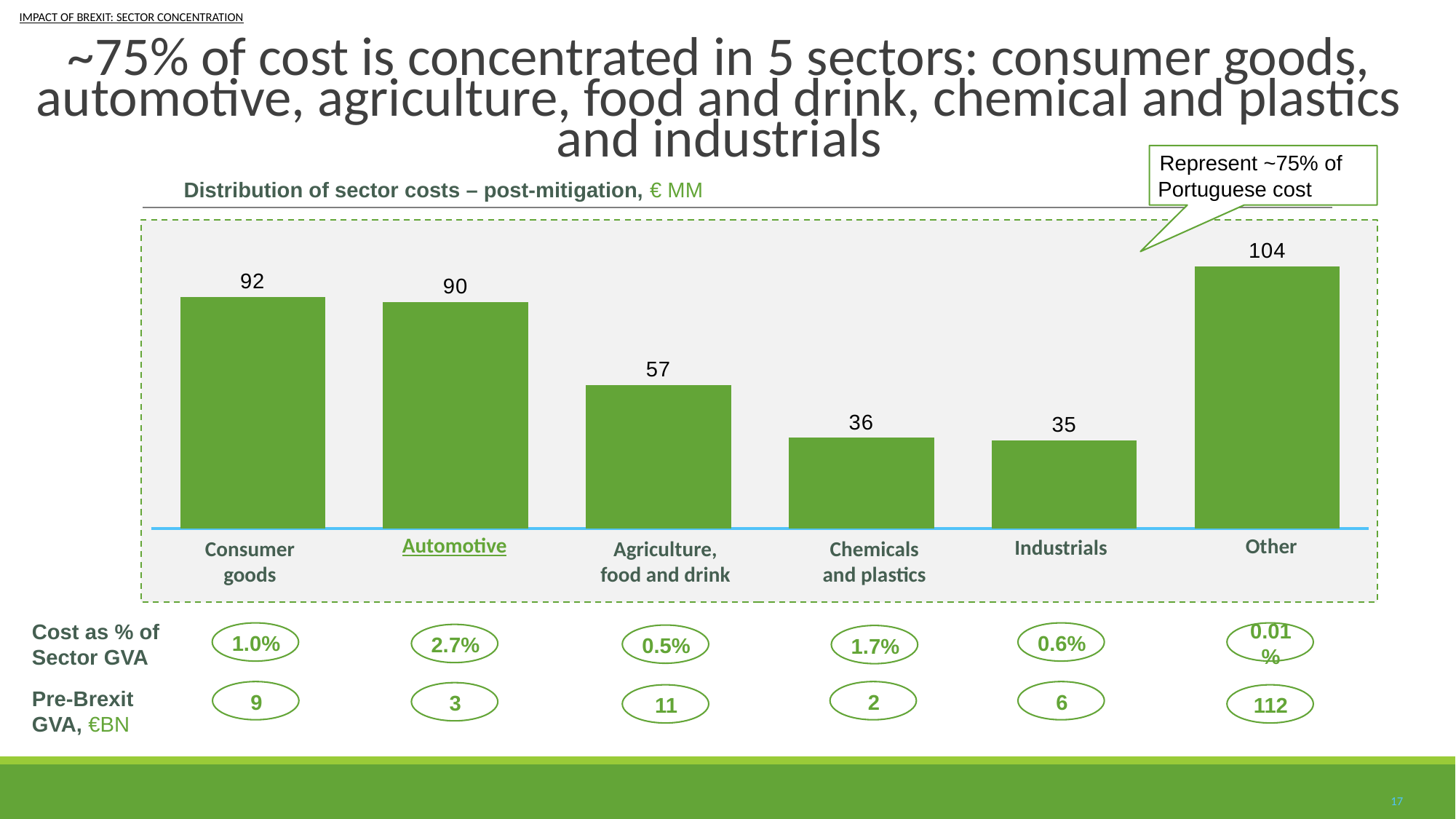
How many categories are shown in the chart? 6 What is the value for Industrials in the chart? 35 Which is larger, the value for Automotive or the value for Chemicals and plastics? Automotive Which category has the highest value in the chart? Other What is the difference between the values for Consumer goods and Automotive? 2 What is the value for Agriculture, food and drink in the chart? 57 Which category has the lowest value in the chart? Industrials What is the value for Consumer goods in the chart? 92 What kind of chart is shown on the slide? Bar chart What is the difference between the values for Other and Agriculture, food and drink? 47 What is the title of the chart? Distribution of sector costs – post-mitigation, € MM What is the total of the values for Consumer goods, Automotive, Agriculture, food and drink, Chemicals and plastics and Industrials? 310